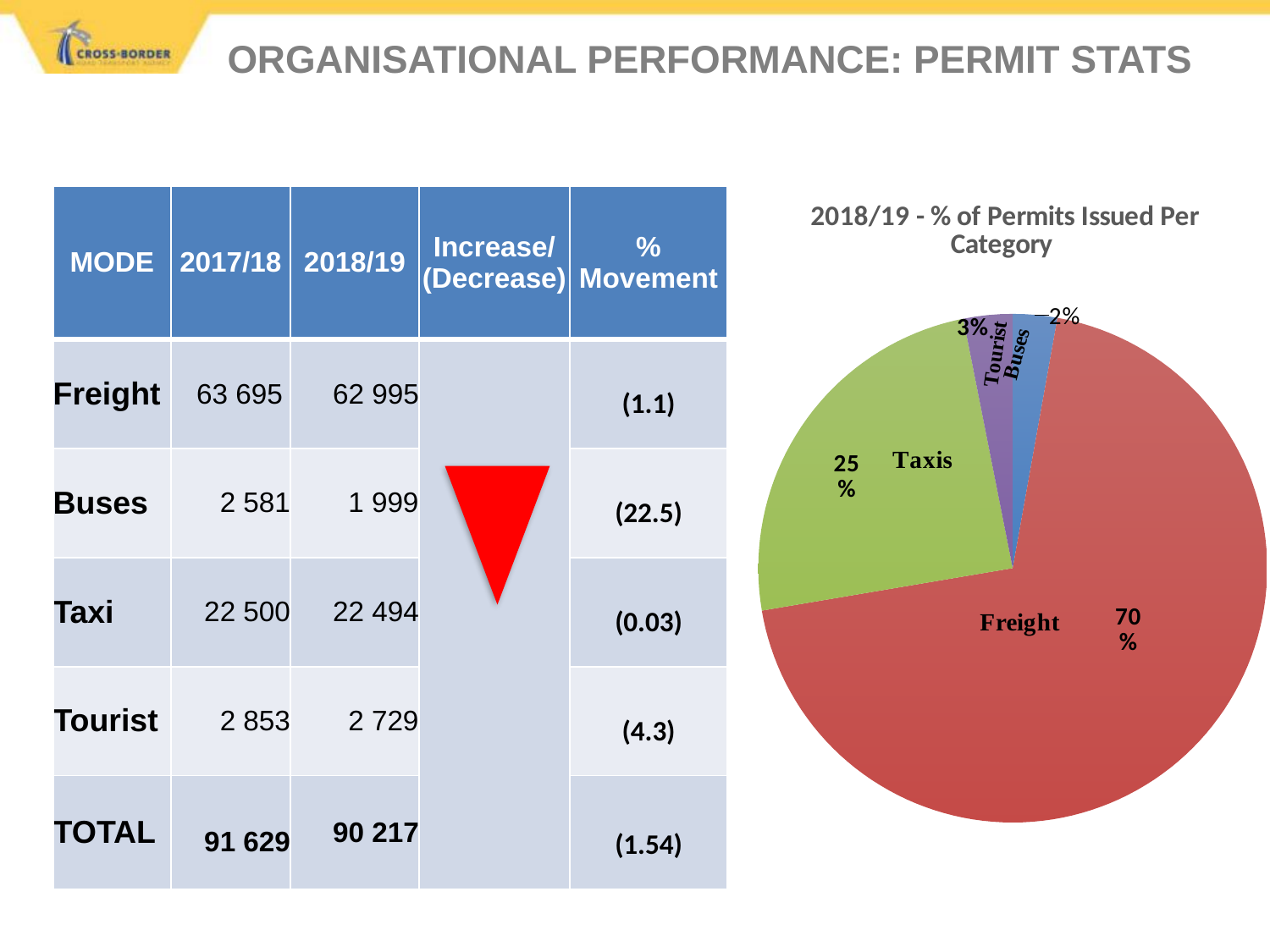
In the pie chart, what share of permits issued is Buses? 2% In the pie chart, what share of permits issued is Freight? 70% How many categories are shown in the pie chart? 4 In the pie chart, what share of permits issued is Taxis? 25% Which category has the largest slice in the pie chart? Freight What is the title of the pie chart? 2018/19 - % of Permits Issued Per Category In the pie chart, which is larger: the Taxis slice or the Tourist slice? Taxis Which category has the smallest slice in the pie chart? Buses In the pie chart, what is the difference in percentage points between the Freight share and the Taxis share? 45 What kind of chart is shown on the slide? pie chart What colour is the Freight slice in the pie chart? red